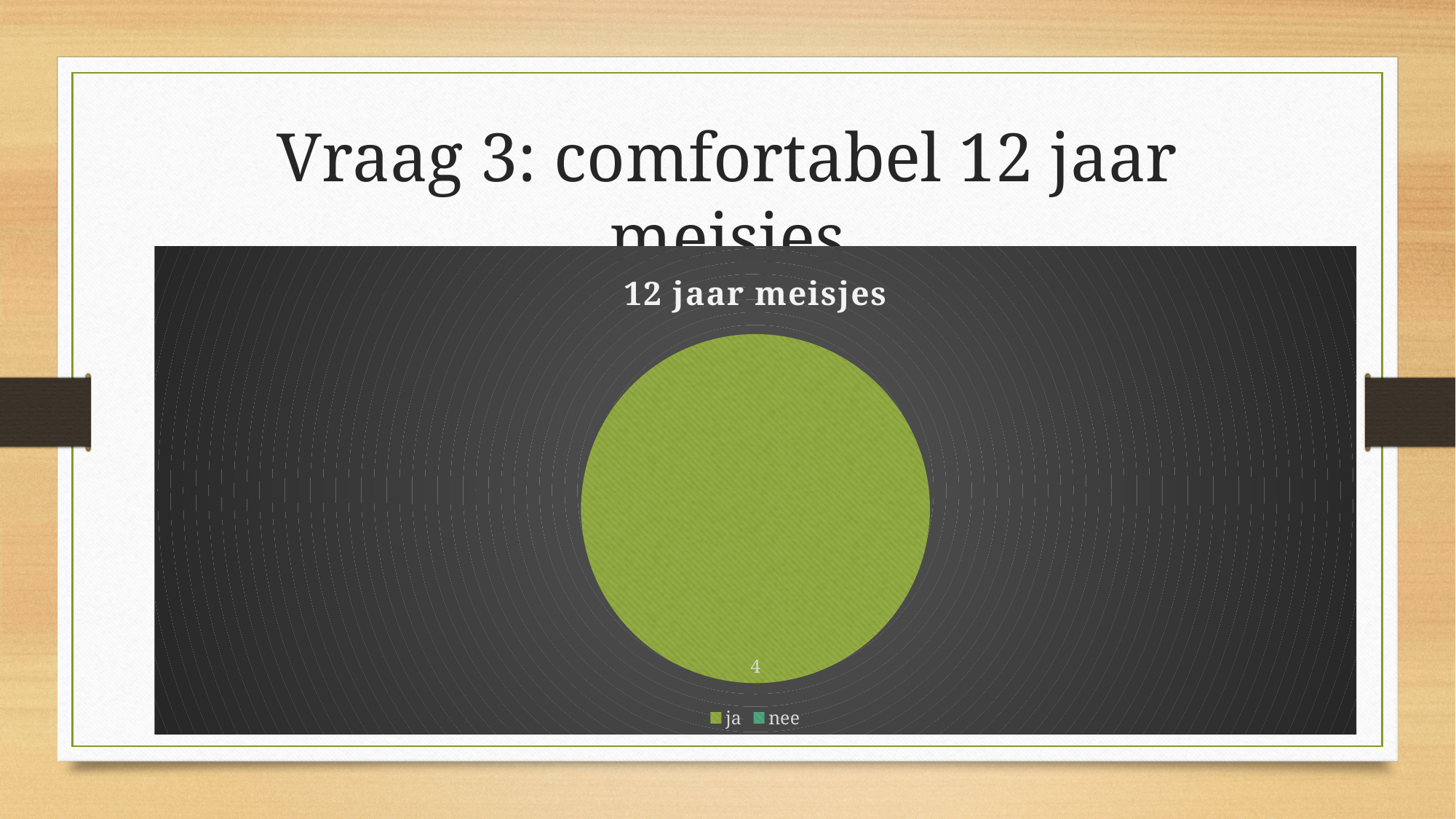
Which category has the largest slice in the pie chart? ja How many entries does the chart legend list? 2 What kind of chart is shown on the slide? pie chart What value is shown for the 'ja' slice of the pie chart? 4 What colour is the 'ja' slice in the pie chart? green Which is larger in the pie chart, 'ja' or 'nee'? ja What is the title of the chart? 12 jaar meisjes How many slices are visible in the pie chart? 1